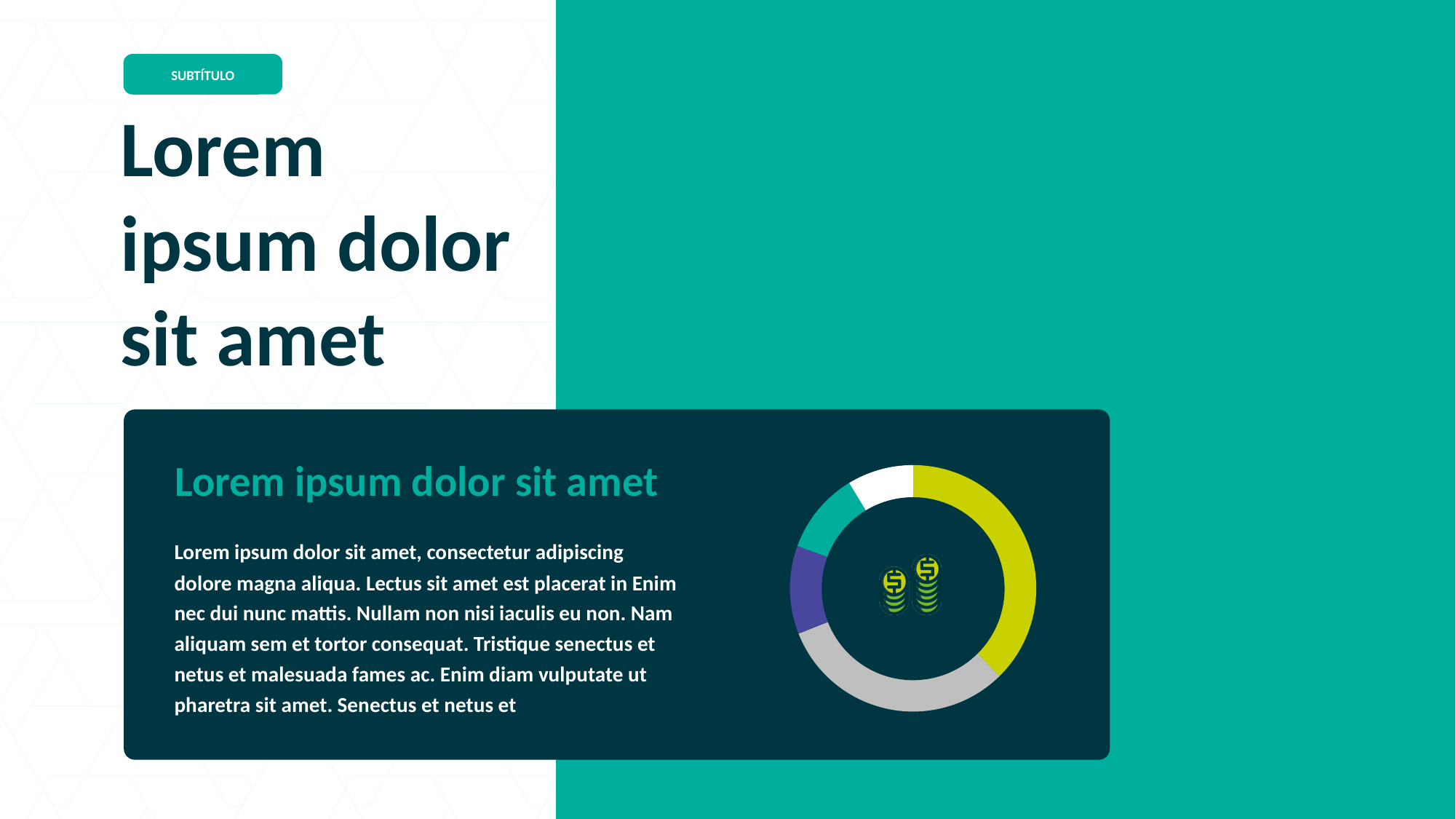
Does the donut chart have a legend? No Which is larger in the donut chart, the yellow-green slice or the grey slice? The yellow-green slice Which colour slice is the largest in the donut chart? Yellow-green What kind of chart is shown on the slide? Donut (pie) chart What icon is shown in the centre of the donut chart? Two stacks of coins with dollar signs How many slices does the donut chart have? 5 Which is larger in the donut chart, the purple slice or the white slice? The purple slice Which is larger in the donut chart, the grey slice or the purple slice? The grey slice